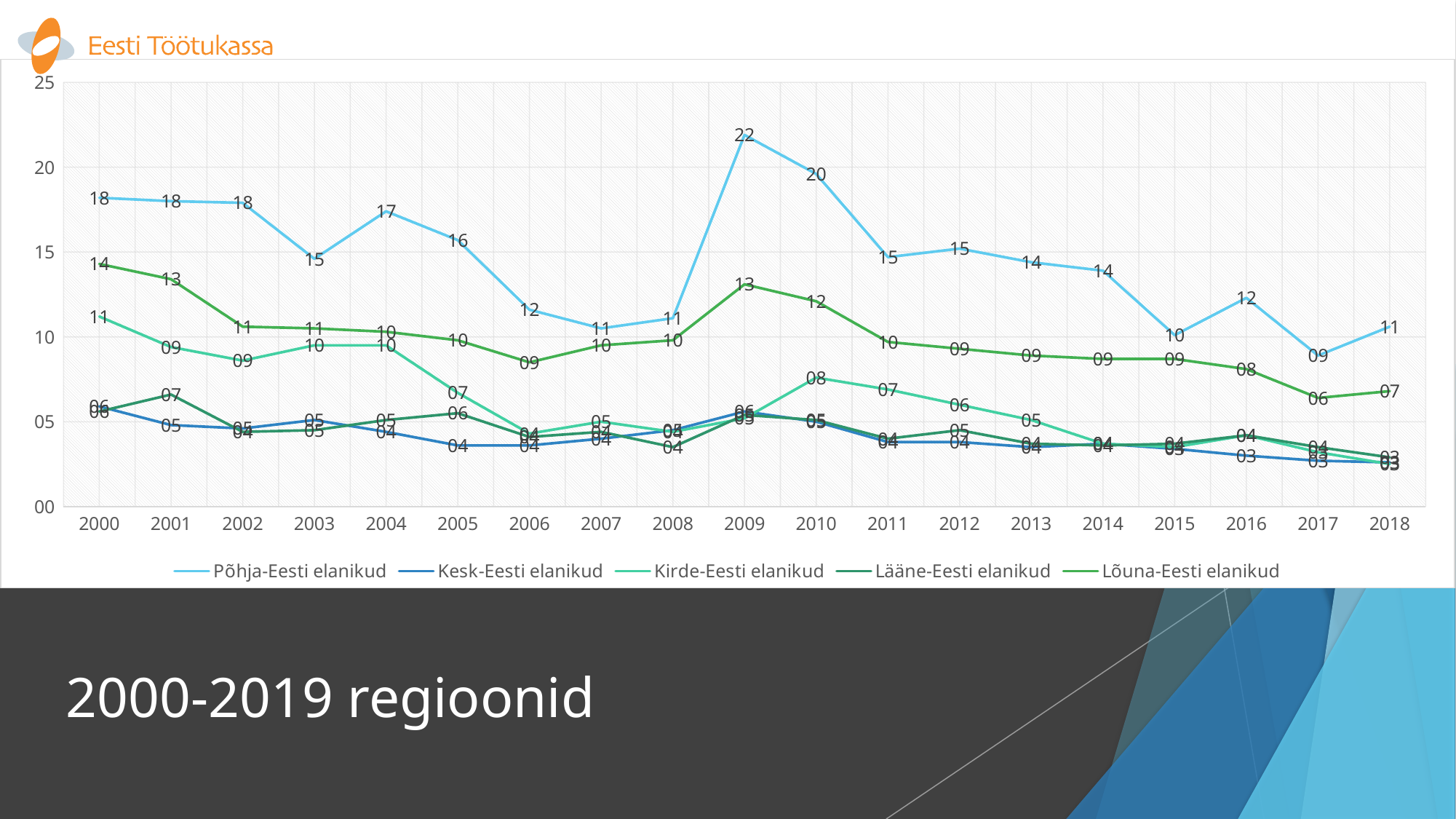
What is the difference between the Põhja-Eesti elanikud values in 2009 and 2010? 2 What is the value for Kirde-Eesti elanikud in 2010? 08 Does the Põhja-Eesti elanikud line rise or fall from 2009 to 2011? fall How many series does the legend list? 5 What kind of chart is shown on the slide? line chart What is the value for Lõuna-Eesti elanikud in 2000? 14 What is the title of the slide below the chart? 2000-2019 regioonid In which year does Põhja-Eesti elanikud reach its highest value? 2009 What is the value for Põhja-Eesti elanikud in 2009? 22 How many years are plotted along the x axis? 19 In which year does Põhja-Eesti elanikud have its lowest value? 2017 In 2009, which is larger: Põhja-Eesti elanikud or Lõuna-Eesti elanikud? Põhja-Eesti elanikud